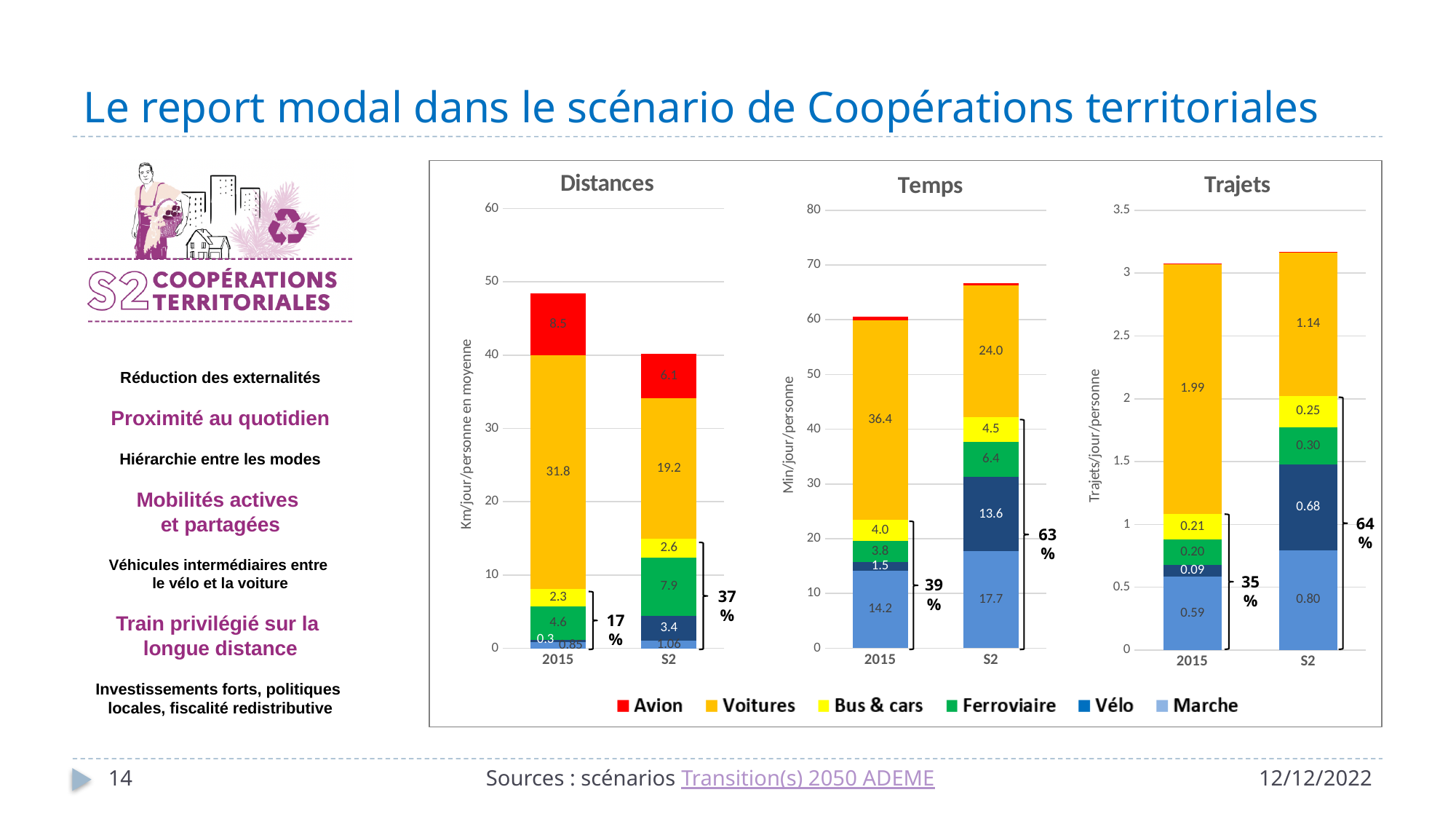
In the "Temps" chart, what is the value for Vélo in S2? 13.6 In the "Trajets" chart, which series has the highest value in S2? Voitures In the "Temps" chart, which is larger: Marche in 2015 or Marche in S2? Marche in S2 In the "Distances" chart, what is the difference between the Voitures value in 2015 and in S2? 12.6 What is the y-axis label of the "Temps" chart? Min/jour/personne In the "Trajets" chart, what is the difference between the Vélo value in S2 and in 2015? 0.59 What kind of chart is the "Distances" chart? stacked bar chart In the "Trajets" chart, what is the value for Marche in 2015? 0.59 In the "Distances" chart, what is the value for Ferroviaire in S2? 7.9 In the "Temps" chart, is the total height of the S2 bar greater or less than 60? greater In the "Distances" chart, what is the value for Voitures in 2015? 31.8 How many series does the shared legend list? 6